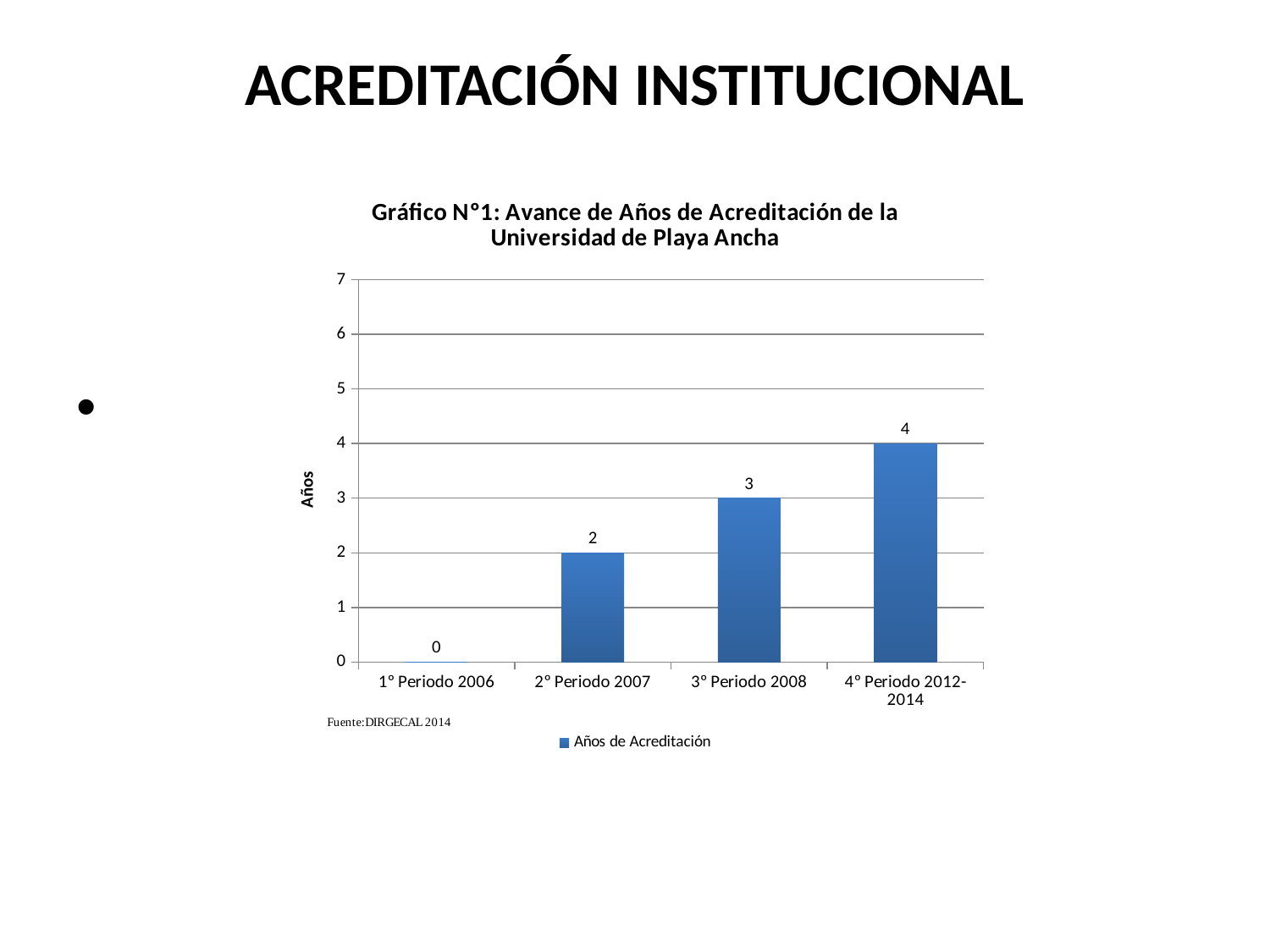
How many series does the legend list? 1 What is the difference between the values for 4° Periodo 2012-2014 and 2° Periodo 2007? 2 How many periods are shown on the x axis? 4 What kind of chart is shown on the slide? bar chart Which is larger, the value for 3° Periodo 2008 or the value for 2° Periodo 2007? 3° Periodo 2008 Is the value for 3° Periodo 2008 greater or less than 5? less Do the values rise or fall from 1° Periodo 2006 to 4° Periodo 2012-2014? rise Which period has the highest number of years of accreditation? 4° Periodo 2012-2014 Which period has the lowest number of years of accreditation? 1° Periodo 2006 What is the value for 2° Periodo 2007? 2 What is the value for 1° Periodo 2006? 0 What is the value for 4° Periodo 2012-2014? 4